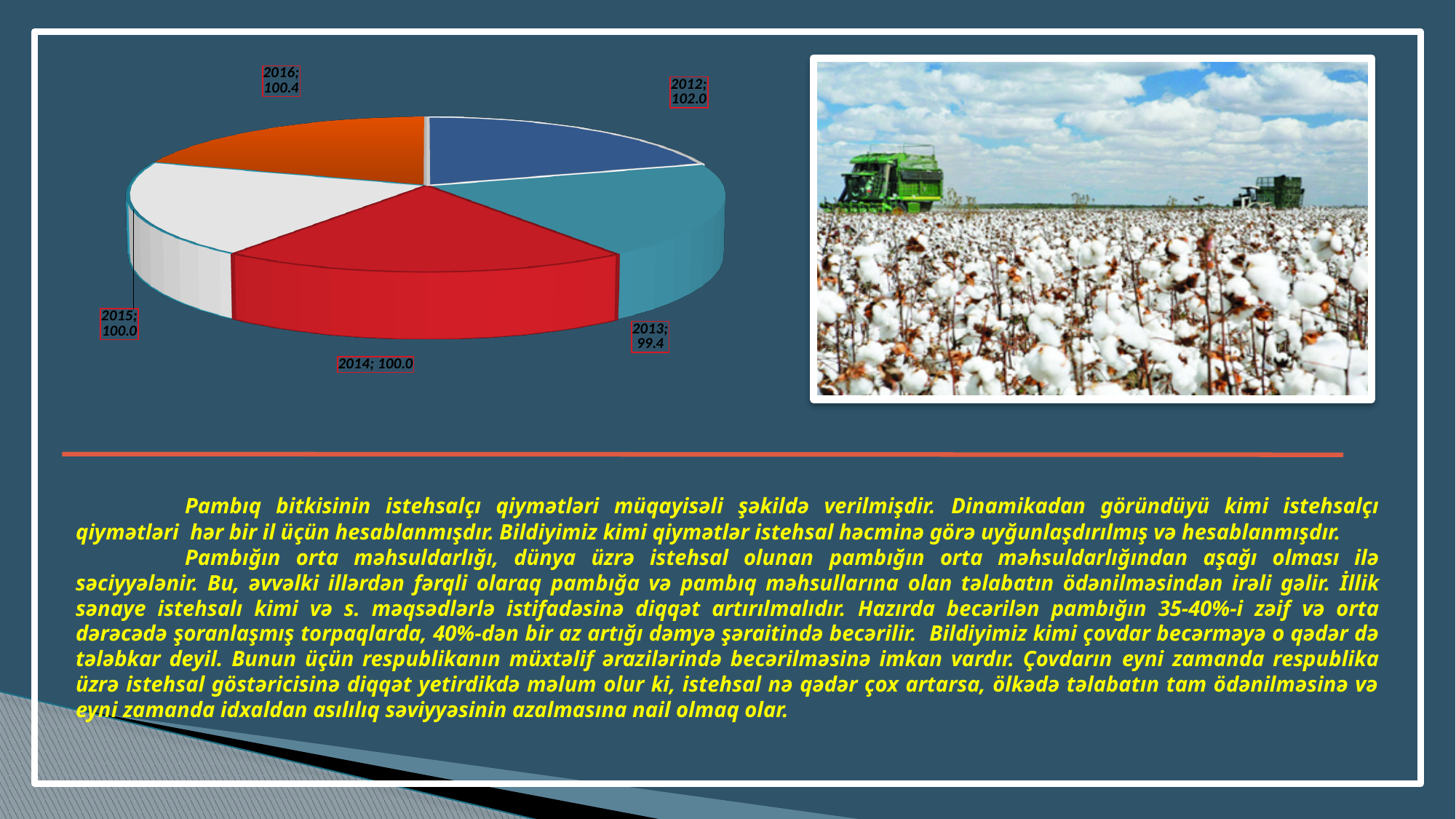
What value is shown for 2013 in the pie chart? 99.4 What is the difference between the values for 2012 and 2013 in the pie chart? 2.6 What value is shown for 2012 in the pie chart? 102.0 Which is larger in the pie chart, the value for 2012 or the value for 2016? 2012 What value is shown for 2015 in the pie chart? 100.0 What kind of chart is shown on the slide? Pie chart What is the difference between the values for 2016 and 2014 in the pie chart? 0.4 Which year has the lowest value in the pie chart? 2013 What colour is the slice for 2014 in the pie chart? Red How many slices (years) does the pie chart have? 5 Which year has the highest value in the pie chart? 2012 What value is shown for 2016 in the pie chart? 100.4